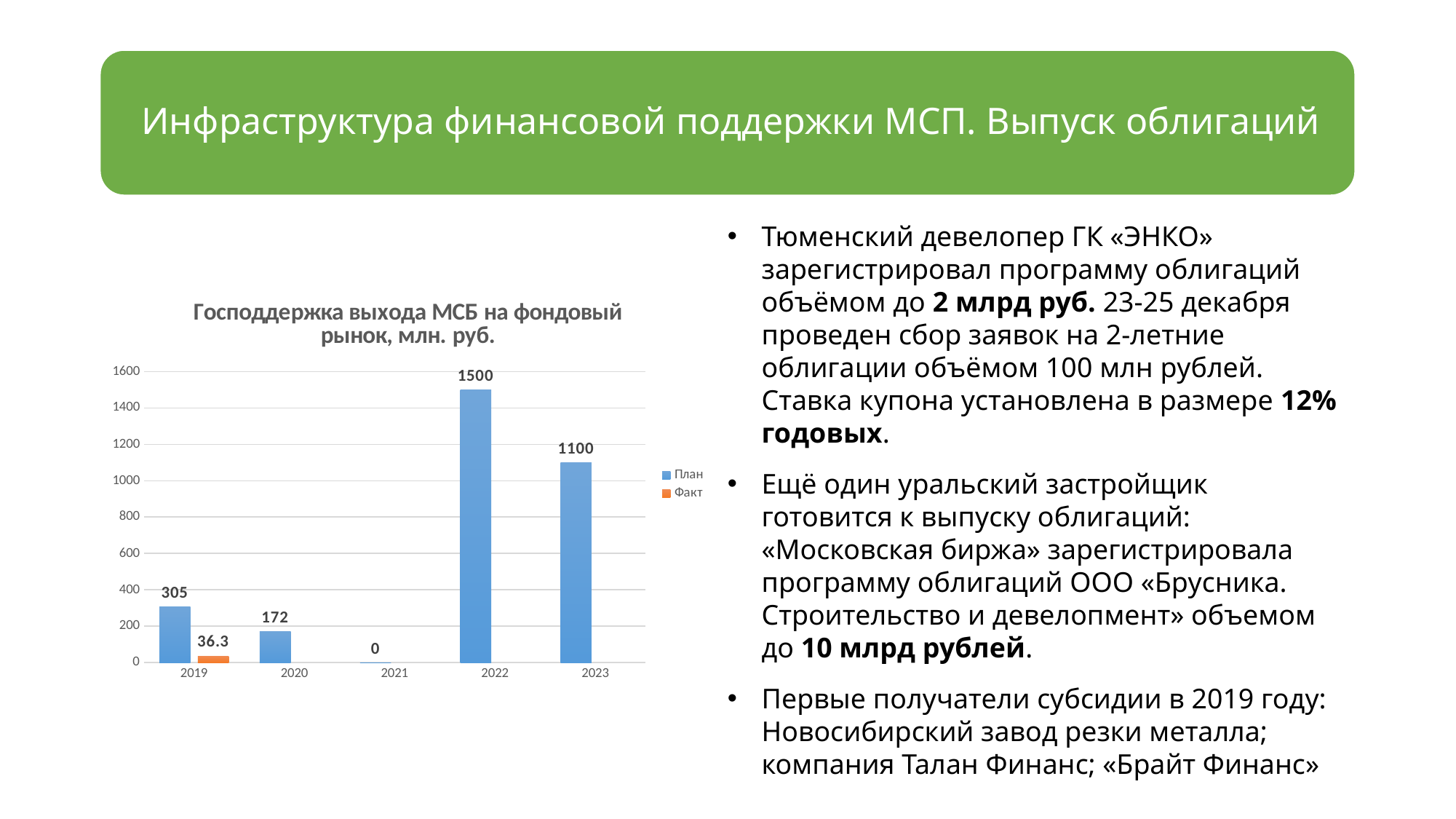
What is the difference between the План values for 2022 and 2023? 400 Which year has the highest План value? 2022 How many series does the chart legend list? 2 How many years are shown on the x axis of the chart? 5 What is the План value for 2021? 0 What is the Факт value for 2019? 36.3 What is the difference between the План and Факт values for 2019? 268.7 What is the План value for 2019? 305 What type of chart is shown on the slide? Bar chart What is the План value for 2022? 1500 Which year has the lowest План value? 2021 Which is larger, the План value for 2019 or for 2020? 2019